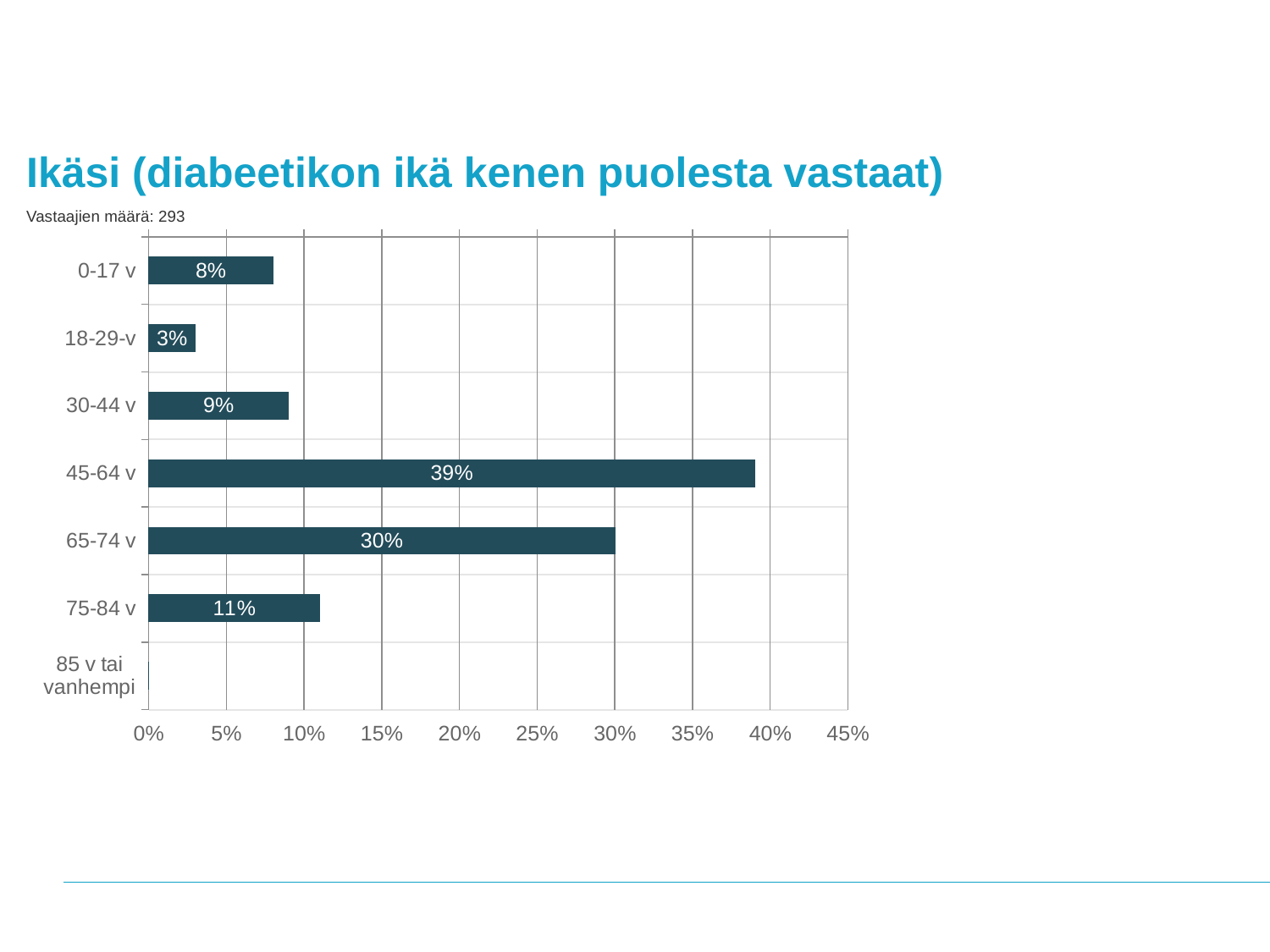
What is the difference between the values for 45-64 v and 65-74 v? 9% What is the value for the 75-84 v age group? 11% Which age group with a labelled bar has the lowest value? 18-29-v What is the value for the 45-64 v age group? 39% What is the value for the 18-29-v age group? 3% Which is larger, the value for 0-17 v or the value for 30-44 v? 30-44 v How many age categories are shown on the y axis? 7 Is the value for 65-74 v greater or less than 25%? greater What is the title of the slide? Ikäsi (diabeetikon ikä kenen puolesta vastaat) What kind of chart is shown on the slide? bar chart Which age group has the highest value? 45-64 v How many respondents (Vastaajien määrä) are stated on the slide? 293